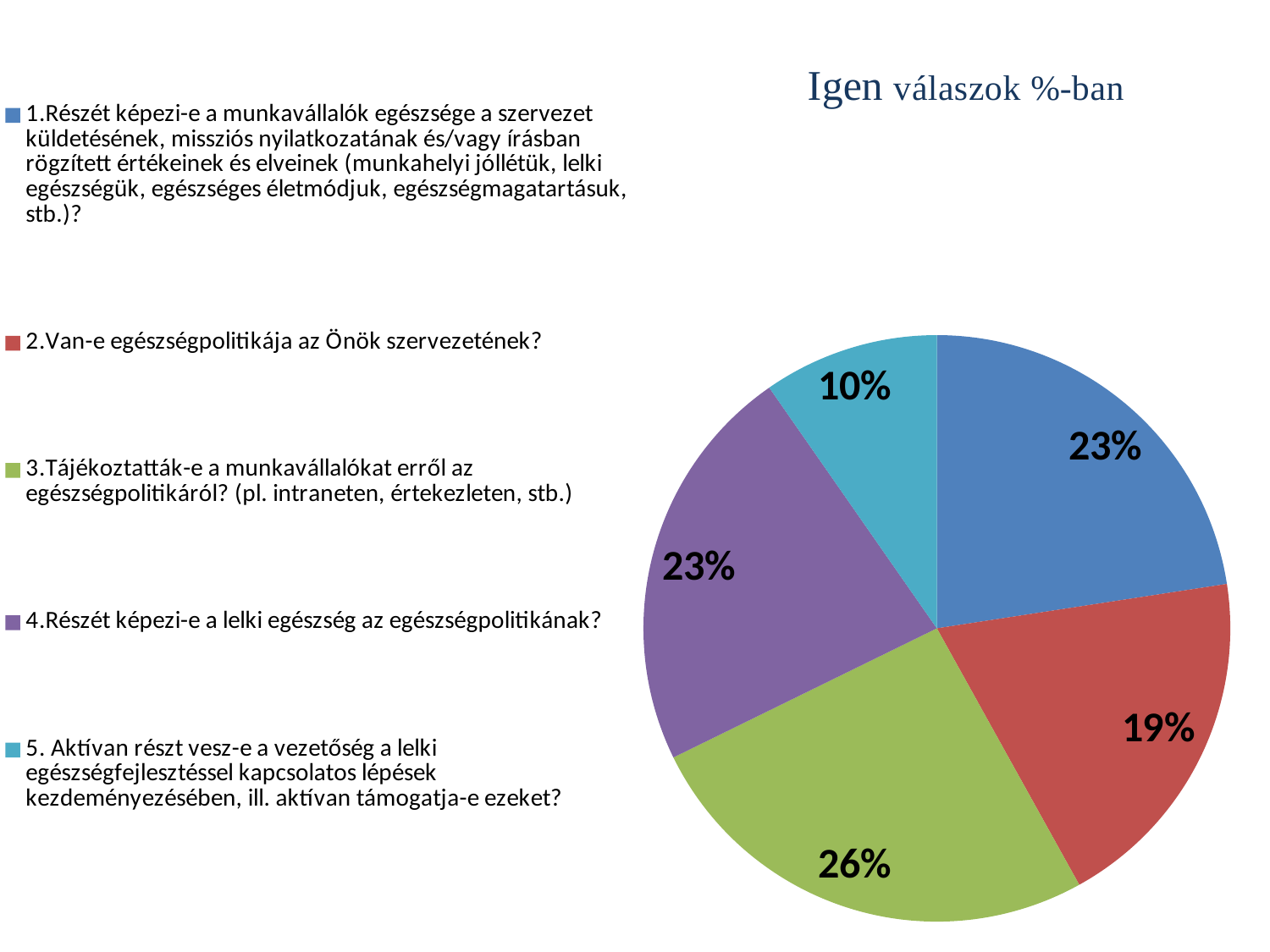
Which question has the smallest slice of the pie? 5. Aktívan részt vesz-e a vezetőség a lelki egészségfejlesztéssel kapcsolatos lépések kezdeményezésében, ill. aktívan támogatja-e ezeket? What percentage is shown for question 4 (Részét képezi-e a lelki egészség az egészségpolitikának?)? 23% Which slice is larger: the one for question 2 or the one for question 5? question 2 What percentage is shown for question 5 (Aktívan részt vesz-e a vezetőség a lelki egészségfejlesztéssel kapcsolatos lépések kezdeményezésében?)? 10% How many slices does the pie chart have? 5 Which question has the largest slice of the pie? 3.Tájékoztatták-e a munkavállalókat erről az egészségpolitikáról? What percentage is shown for question 3 (Tájékoztatták-e a munkavállalókat erről az egészségpolitikáról?)? 26% What percentage is shown for question 2 (Van-e egészségpolitikája az Önök szervezetének?)? 19% What kind of chart is shown on the slide? pie chart What colour is the slice for question 1 (Részét képezi-e a munkavállalók egészsége a szervezet küldetésének...)? blue What is the title of the chart? Igen válaszok %-ban What is the difference in percentage points between the slice for question 3 and the slice for question 2? 7